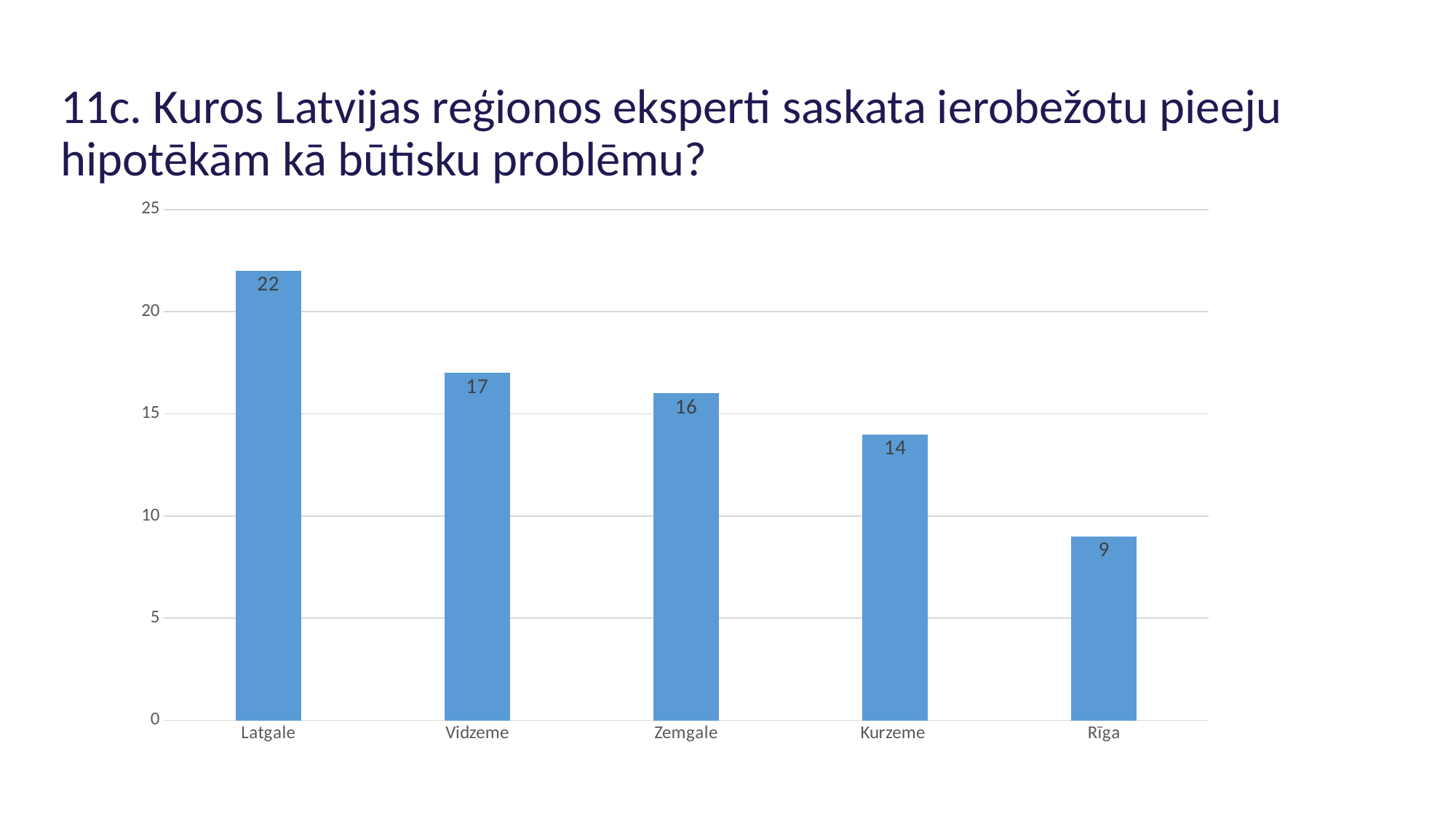
Which region has the highest value? Latgale How many regions are shown on the chart? 5 What is the value for Latgale? 22 What is the difference between the values for Vidzeme and Kurzeme? 3 Which is larger, the value for Vidzeme or the value for Zemgale? Vidzeme Which region has the lowest value? Rīga What is the difference between the values for Latgale and Rīga? 13 What is the value for Rīga? 9 Is the value for Kurzeme greater or less than 15? less What is the value for Zemgale? 16 What kind of chart is shown on the slide? bar chart Do the values rise or fall from left to right along the x axis? fall